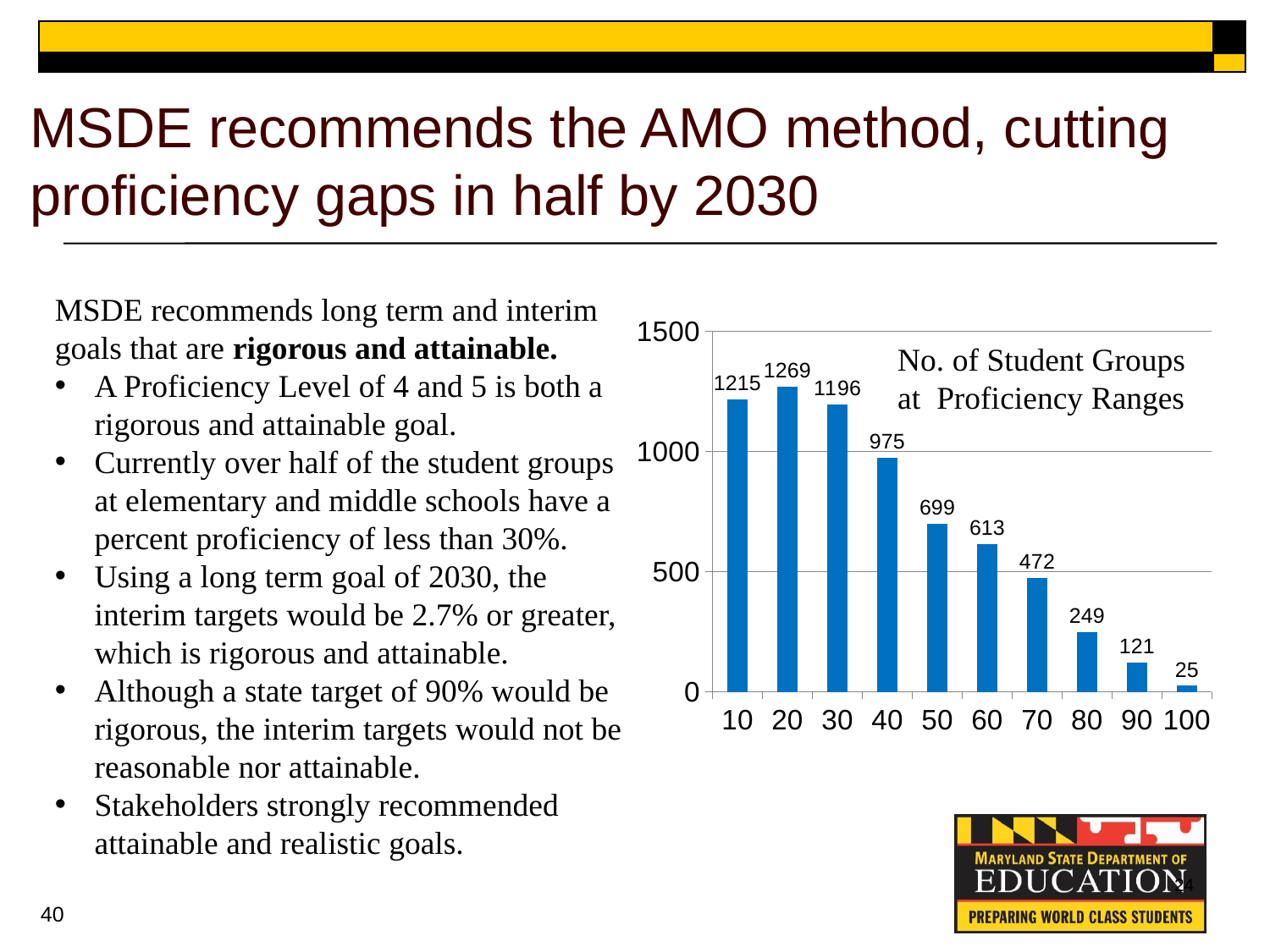
What is the title of the chart? No. of Student Groups at Proficiency Ranges Which proficiency range has the highest number of student groups? 20 Do the values generally rise or fall from the 20 range to the 100 range? fall Which proficiency range has the lowest number of student groups? 100 What is the value for the 50 proficiency range? 699 What is the value for the 20 proficiency range? 1269 What kind of chart is shown on the slide? bar chart How many proficiency ranges are shown on the x axis? 10 Is the value for the 70 proficiency range greater or less than 500? less What is the value for the 90 proficiency range? 121 Which is larger, the value for the 10 range or the value for the 30 range? 10 What is the difference between the values for the 40 and 50 proficiency ranges? 276